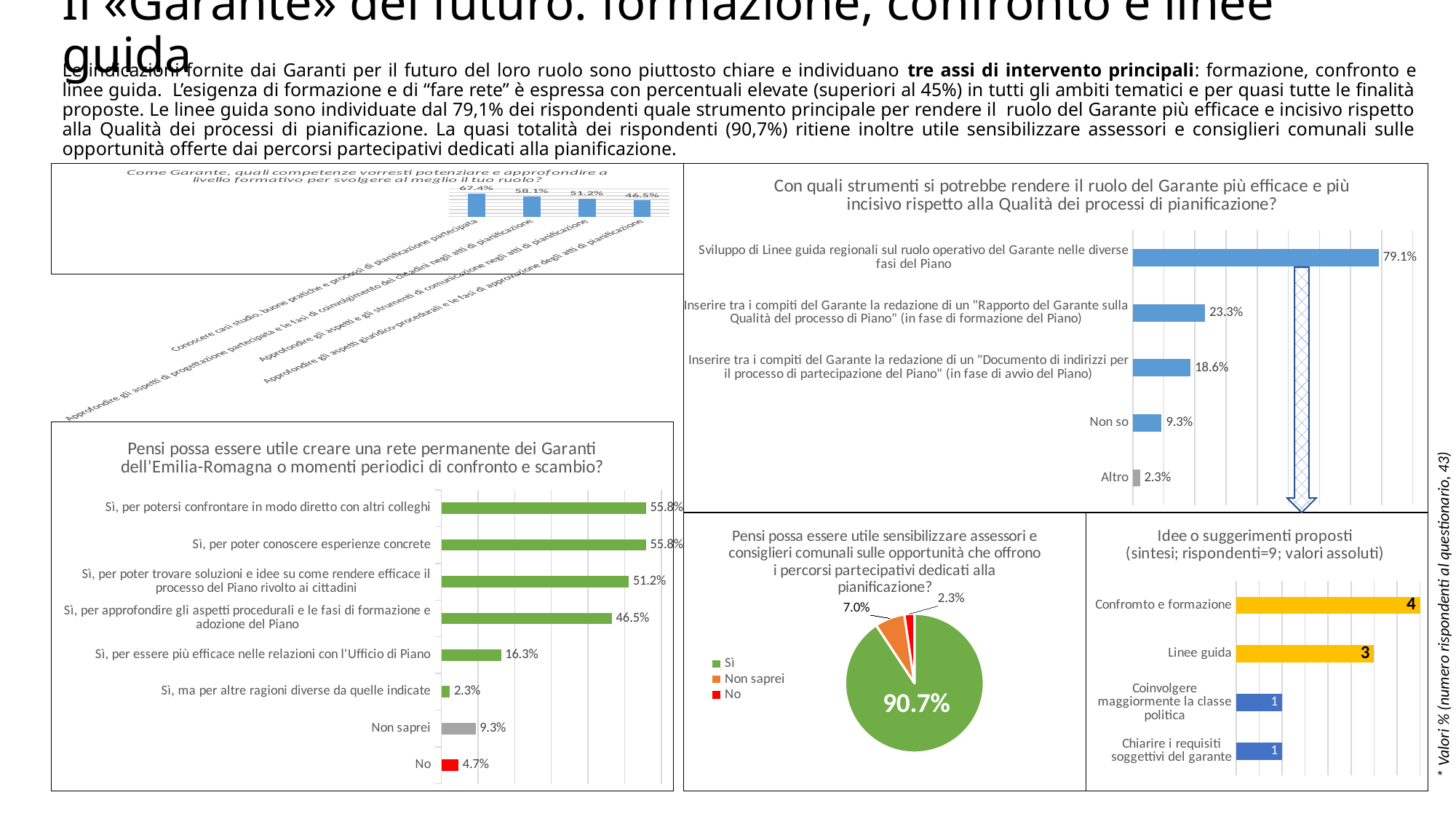
In the chart titled "Pensi possa essere utile creare una rete permanente dei Garanti...", which is larger: the value for "Sì, per essere più efficace nelle relazioni con l'Ufficio di Piano" or the value for "Non saprei"? Sì, per essere più efficace nelle relazioni con l'Ufficio di Piano In the chart titled "Con quali strumenti si potrebbe rendere il ruolo del Garante più efficace...", how many categories are shown? 5 In the chart titled "Pensi possa essere utile creare una rete permanente dei Garanti...", what is the value for "No"? 4.7% In the chart titled "Idee o suggerimenti proposti", what is the difference between the value for "Confronto e formazione" and the value for "Chiarire i requisiti soggettivi del garante"? 3 In the chart titled "Con quali strumenti si potrebbe rendere il ruolo del Garante più efficace...", which category has the highest value? Sviluppo di Linee guida regionali sul ruolo operativo del Garante nelle diverse fasi del Piano In the pie chart titled "Pensi possa essere utile sensibilizzare assessori e consiglieri comunali...", what share does "Non saprei" have? 7.0% In the chart titled "Pensi possa essere utile creare una rete permanente dei Garanti...", how many categories are shown? 8 In the chart titled "Con quali strumenti si potrebbe rendere il ruolo del Garante più efficace...", what is the difference between the value for "Sviluppo di Linee guida regionali..." and the value for "Altro"? 76.8% What kind of chart is the one titled "Pensi possa essere utile sensibilizzare assessori e consiglieri comunali..."? Pie chart In the chart titled "Con quali strumenti si potrebbe rendere il ruolo del Garante più efficace...", what is the value for "Non so"? 9.3% In the chart titled "Pensi possa essere utile creare una rete permanente dei Garanti...", which category has the lowest value? Sì, ma per altre ragioni diverse da quelle indicate In the chart titled "Idee o suggerimenti proposti", what is the value for "Linee guida"? 3